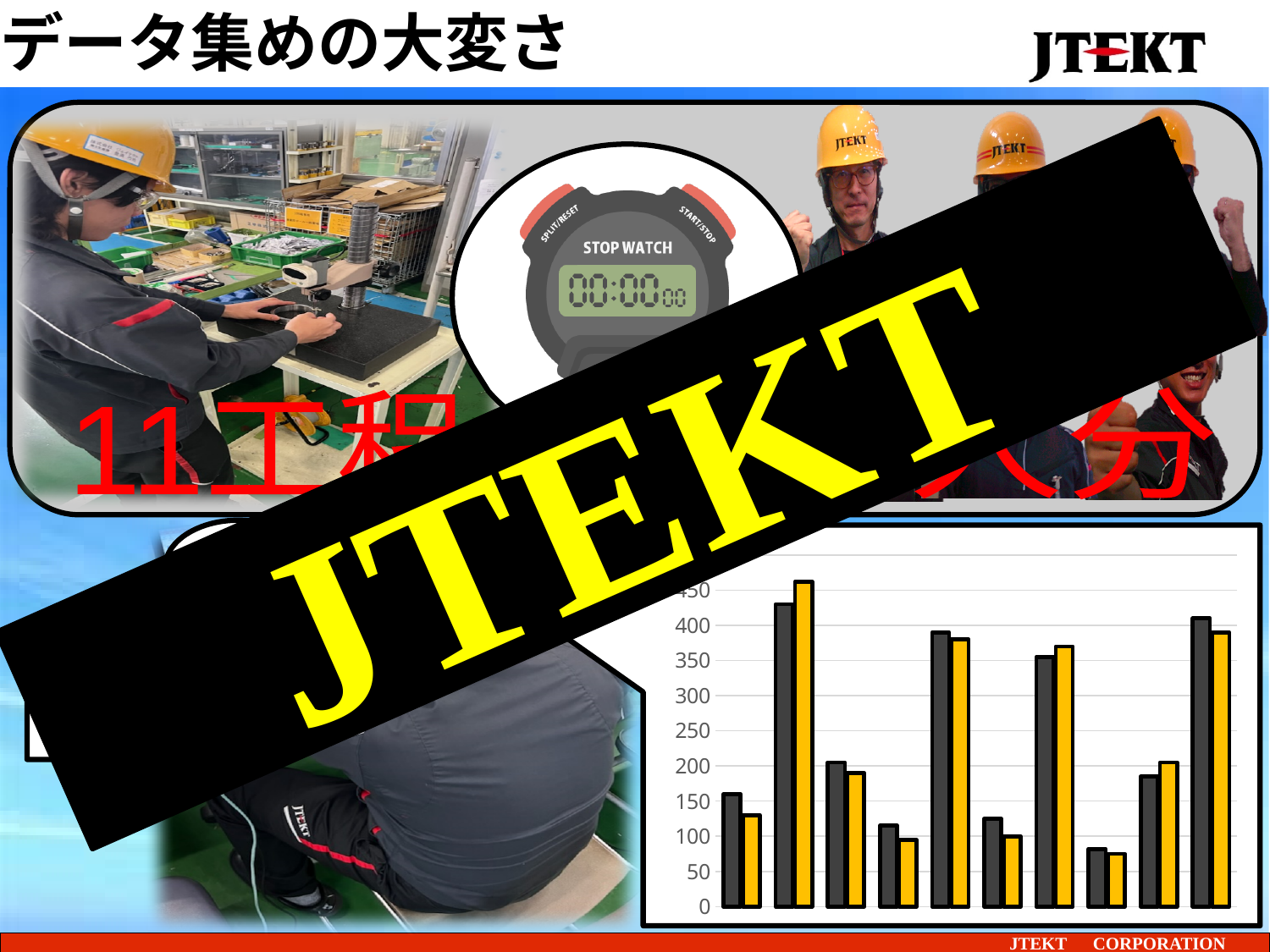
In the bar chart at the bottom right, in the second group from the left, which bar is taller: the dark grey bar or the orange bar? the orange bar In the bar chart at the bottom right, is the dark grey bar in the first group from the left greater or less than 200? less In the bar chart at the bottom right, which group of bars from the left contains the tallest bar? the second group In the bar chart at the bottom right, is the dark grey bar in the fifth group from the left greater or less than 350? greater How many bar series (colours) are plotted in the bar chart at the bottom right? 2 What two colours are used for the bars in the bar chart at the bottom right? dark grey and orange In the bar chart at the bottom right, which group of bars from the left has the lowest bars? the eighth group In the bar chart at the bottom right, is the orange bar in the second group from the left greater or less than 450? greater What kind of chart is shown at the bottom right of the slide? bar chart How many groups of bars (categories) does the bar chart at the bottom right show? 10